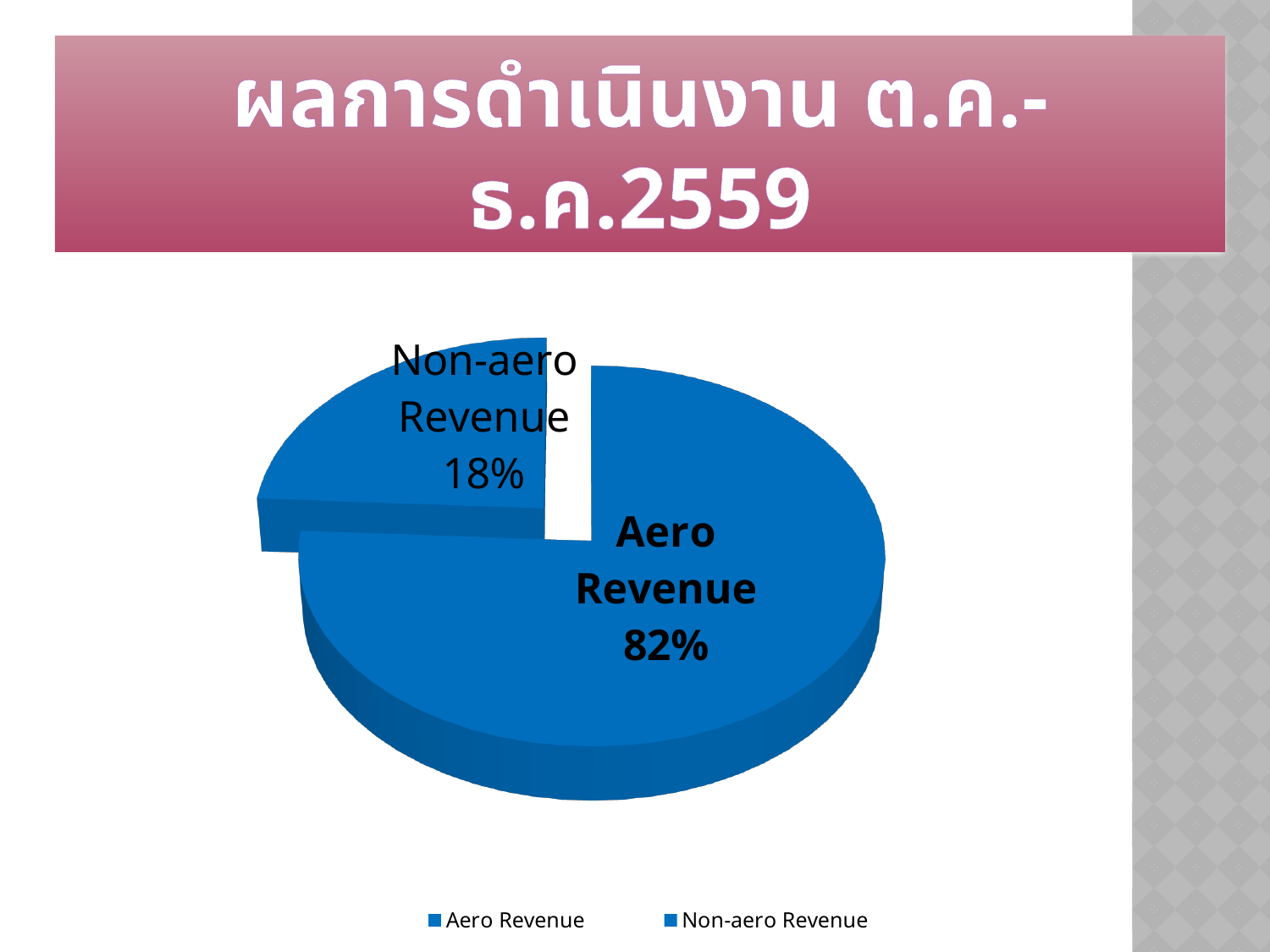
What kind of chart is shown on the slide? pie chart How many slices does the pie chart have? 2 Which slice of the pie is the largest? Aero Revenue Is the share for Non-aero Revenue greater or less than 50%? less How many entries does the legend list? 2 What share of the pie does Non-aero Revenue represent? 18% What share of the pie does Aero Revenue represent? 82% What are the two legend entries of the pie chart? Aero Revenue and Non-aero Revenue What is the difference in percentage points between Aero Revenue and Non-aero Revenue? 64 Which slice of the pie is the smallest? Non-aero Revenue Which is larger, Aero Revenue or Non-aero Revenue? Aero Revenue